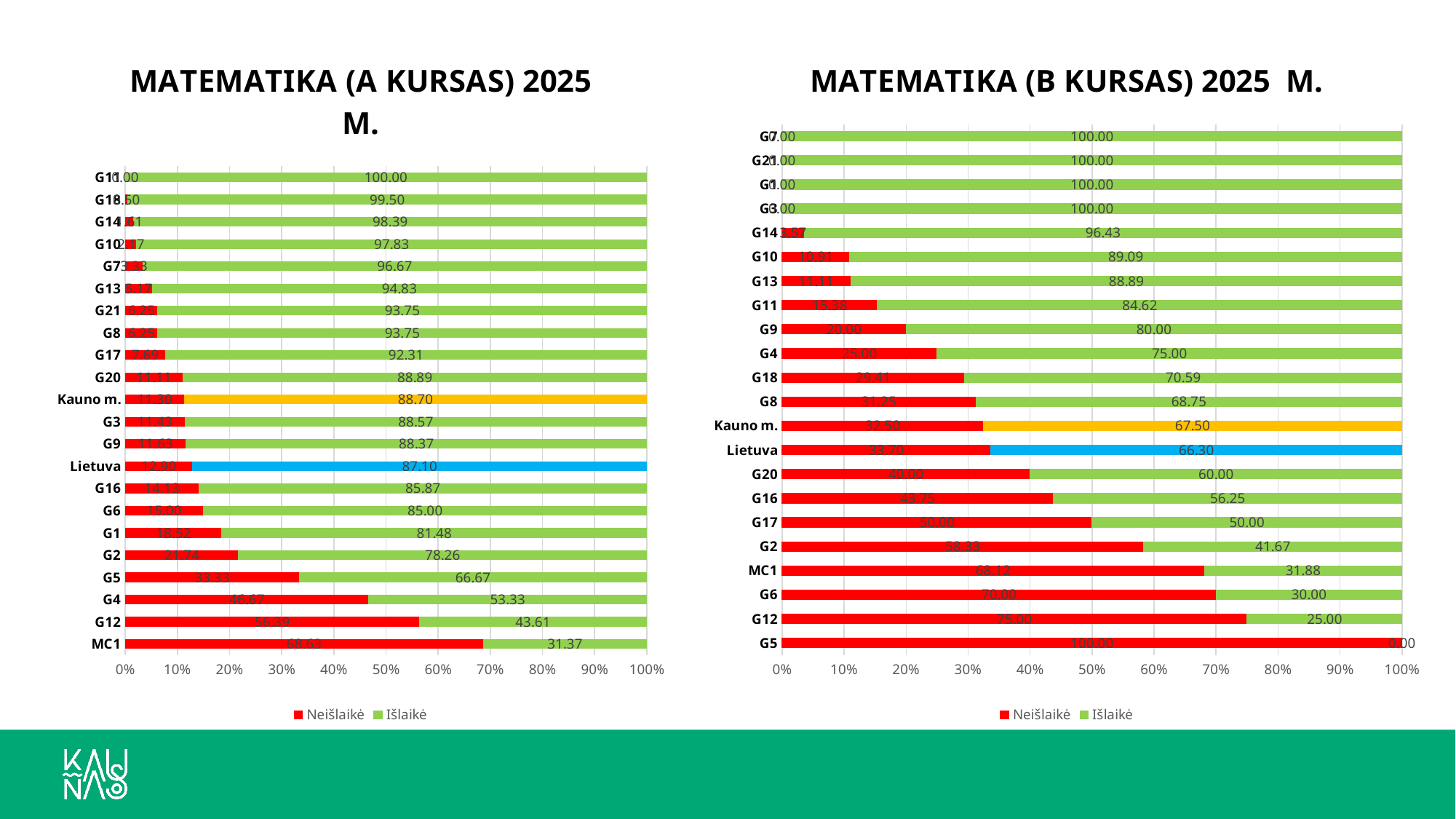
In the MATEMATIKA (B KURSAS) 2025 M. chart, which has a larger Išlaikė value, G9 or G4? G9 In the MATEMATIKA (B KURSAS) 2025 M. chart, what is the Išlaikė value for Lietuva? 66.30 How many categories are shown in the MATEMATIKA (B KURSAS) 2025 M. chart? 22 In the MATEMATIKA (B KURSAS) 2025 M. chart, which category has the highest Neišlaikė value? G5 What kind of chart is the MATEMATIKA (A KURSAS) 2025 M. chart? Stacked bar chart In the MATEMATIKA (B KURSAS) 2025 M. chart, what is the Neišlaikė value for G12? 75.00 In the MATEMATIKA (A KURSAS) 2025 M. chart, what is the difference between the Išlaikė values for Kauno m. and Lietuva? 1.60 In the MATEMATIKA (A KURSAS) 2025 M. chart, what is the Išlaikė value for Kauno m.? 88.70 In the MATEMATIKA (B KURSAS) 2025 M. chart, what is the total of the stacked bar for G17? 100.00 In the MATEMATIKA (A KURSAS) 2025 M. chart, what is the Neišlaikė value for MC1? 68.63 How many series does the legend of the MATEMATIKA (A KURSAS) 2025 M. chart list? 2 In the MATEMATIKA (A KURSAS) 2025 M. chart, which category has the lowest Išlaikė value? MC1